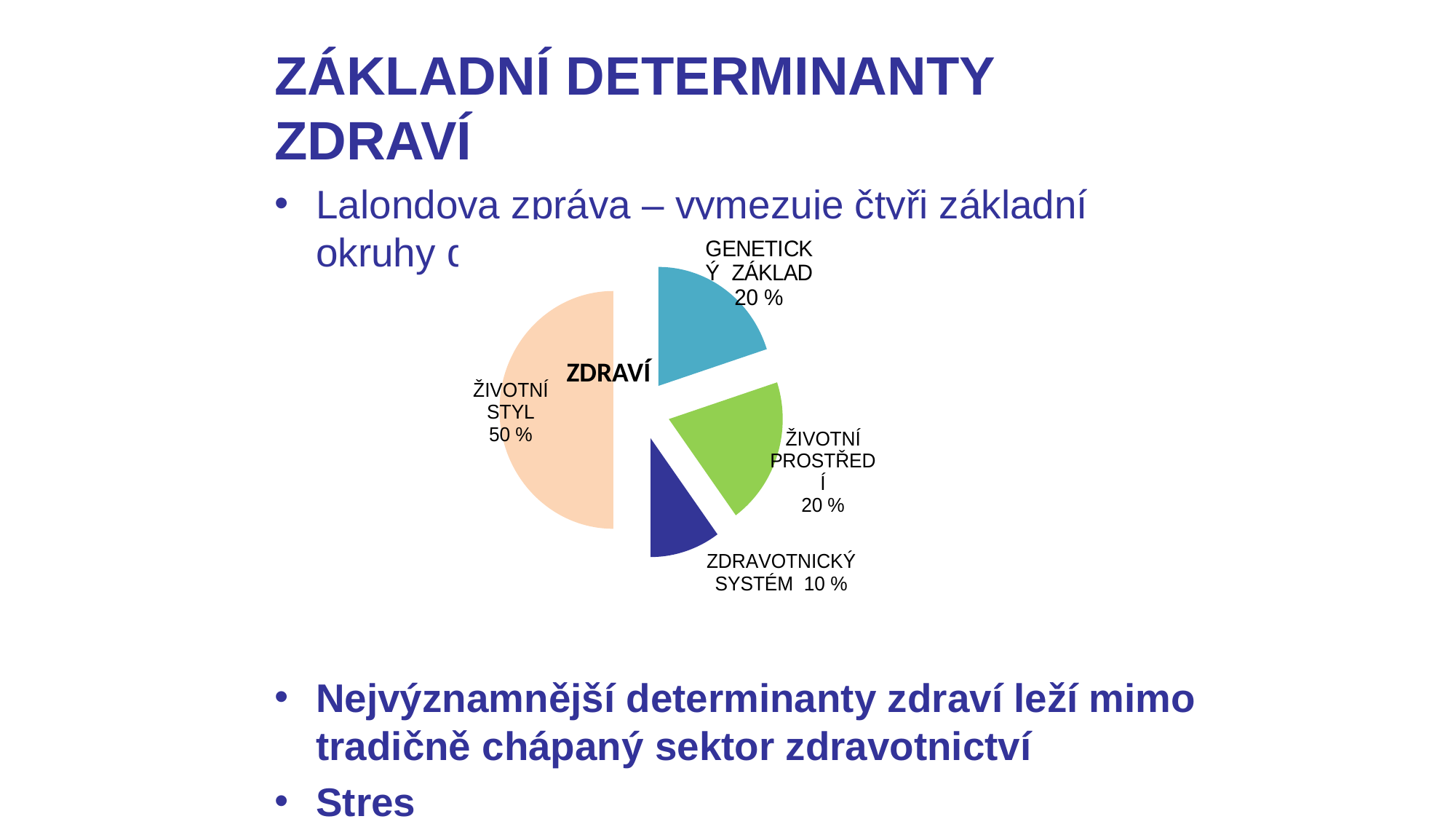
What is the value for ŽIVOTNÍ PROSTŘEDÍ? 20 % What label is printed in the centre of the pie chart? ZDRAVÍ What is the value for ZDRAVOTNICKÝ SYSTÉM? 10 % Which slice of the pie is the smallest? ZDRAVOTNICKÝ SYSTÉM Which slice of the pie is the largest? ŽIVOTNÍ STYL What kind of chart is shown on the slide? pie chart What is the value for ŽIVOTNÍ STYL? 50 % How many slices does the pie chart have? 4 What colour is the ŽIVOTNÍ PROSTŘEDÍ slice? green What is the value for GENETICKÝ ZÁKLAD? 20 % What is the difference between the values for ŽIVOTNÍ STYL and ZDRAVOTNICKÝ SYSTÉM? 40 % Which is larger, the value for ŽIVOTNÍ STYL or the value for GENETICKÝ ZÁKLAD? ŽIVOTNÍ STYL